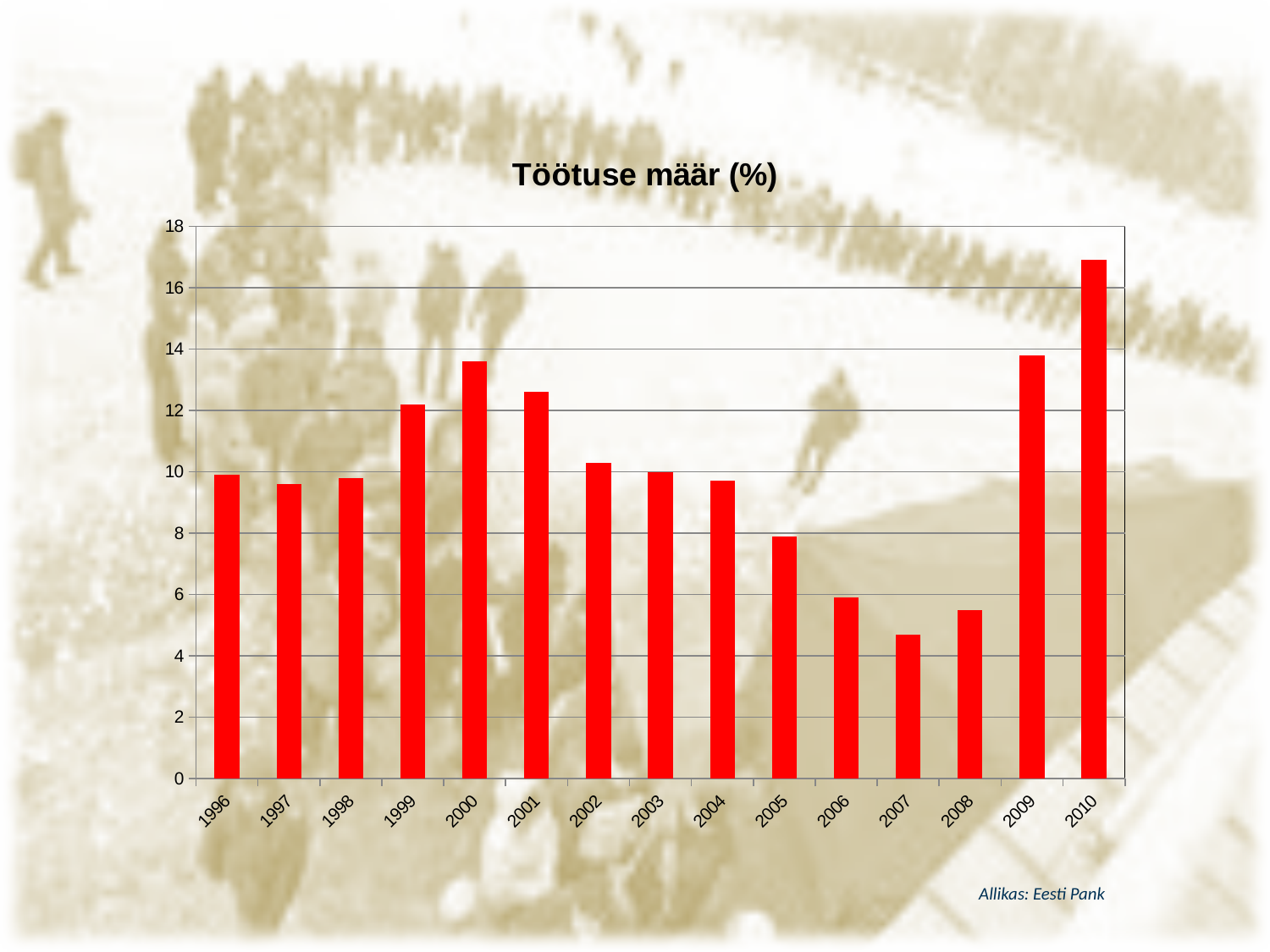
Which year has the larger value, 2000 or 2001? 2000 Is the value for 2010 greater or less than 16? greater What kind of chart is shown on the slide? bar chart Is the value for 2000 greater or less than 14? less What is the title of the chart? Töötuse määr (%) How many years are shown on the x axis of the chart? 15 Do the values rise or fall from 2004 to 2007? fall Which year has the highest unemployment rate in the chart? 2010 What source is cited below the chart? Allikas: Eesti Pank Is the value for 2008 greater or less than 6? less Which year has the lowest unemployment rate in the chart? 2007